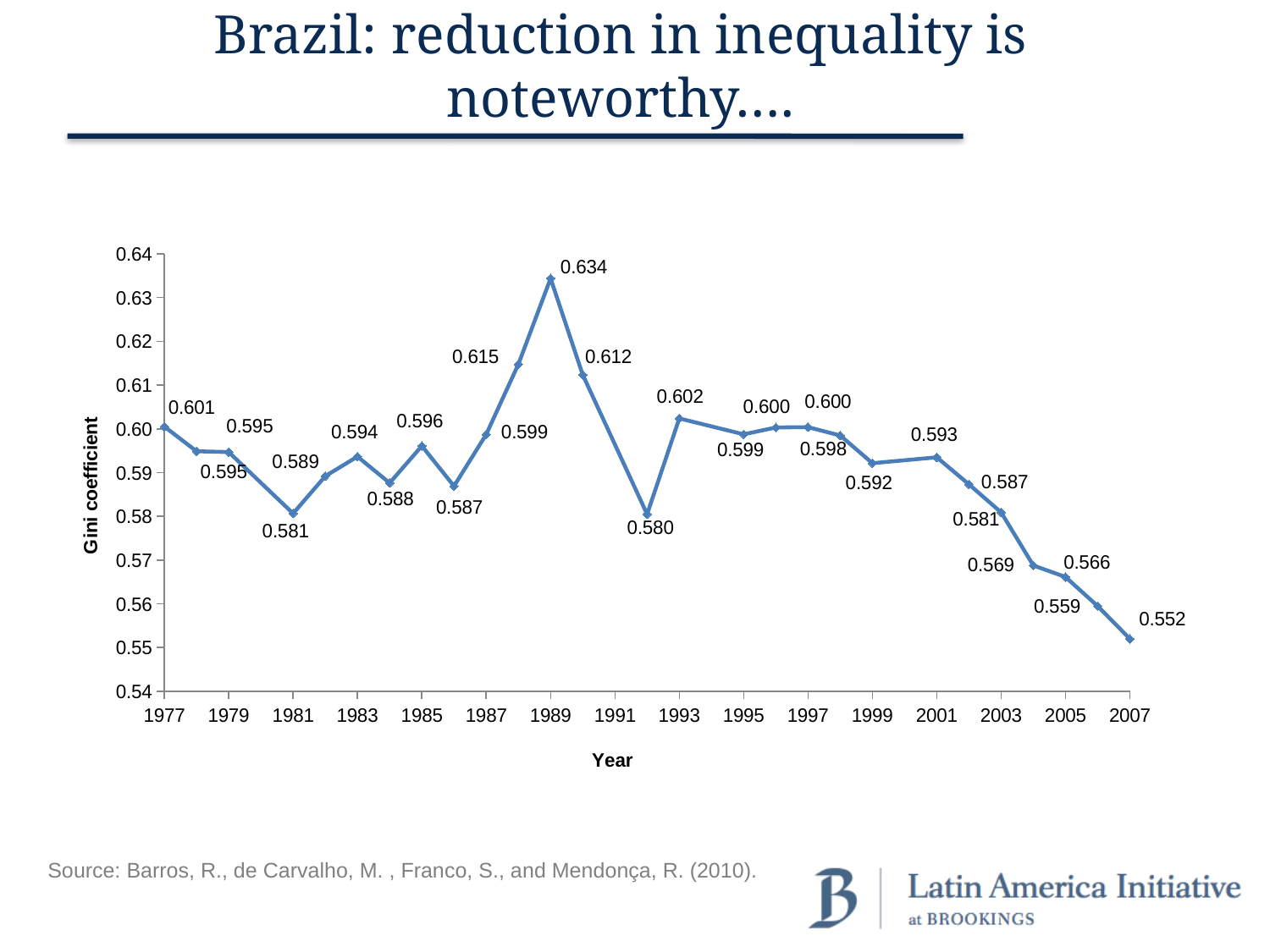
Overall, does the Gini coefficient rise or fall from 1977 to 2007? Fall What is the difference between the Gini coefficient in 1989 and in 2007? 0.082 What is the Gini coefficient for Brazil in 1989? 0.634 What is the label on the vertical axis of the chart? Gini coefficient Is the Gini coefficient for 2005 greater or less than 0.57? less Which year has a higher Gini coefficient, 1989 or 1993? 1989 In which year is the Gini coefficient highest? 1989 What is the Gini coefficient for Brazil in 1992? 0.580 What type of chart is shown on the slide? Line chart In which year is the Gini coefficient lowest? 2007 What is the Gini coefficient for Brazil in 1977? 0.601 What is the Gini coefficient for Brazil in 2007? 0.552